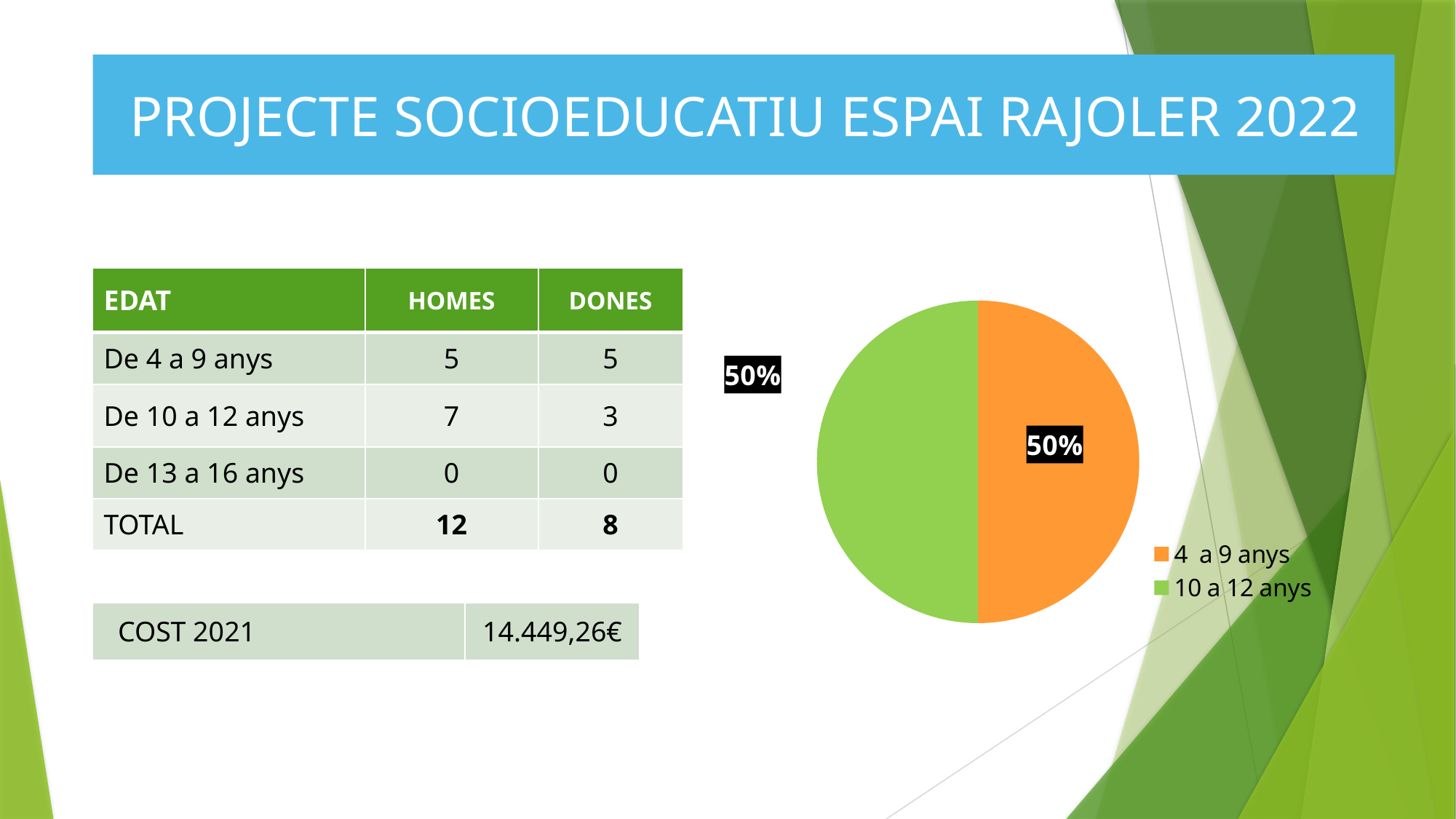
What is the data label shown on the orange slice of the pie chart? 50% What kind of chart is shown on the slide? pie chart What is the data label shown on the green slice of the pie chart? 50% What is the difference between the shares of the '4 a 9 anys' and '10 a 12 anys' slices in the pie chart? 0% What share of the pie chart does the '10 a 12 anys' slice represent? 50% What share of the pie chart does the '4 a 9 anys' slice represent? 50% Which colour represents '10 a 12 anys' in the pie chart? green How many entries does the pie chart's legend list? 2 How many slices does the pie chart have? 2 Is the share of the '10 a 12 anys' slice in the pie chart greater or less than 25%? greater Which colour represents '4 a 9 anys' in the pie chart? orange